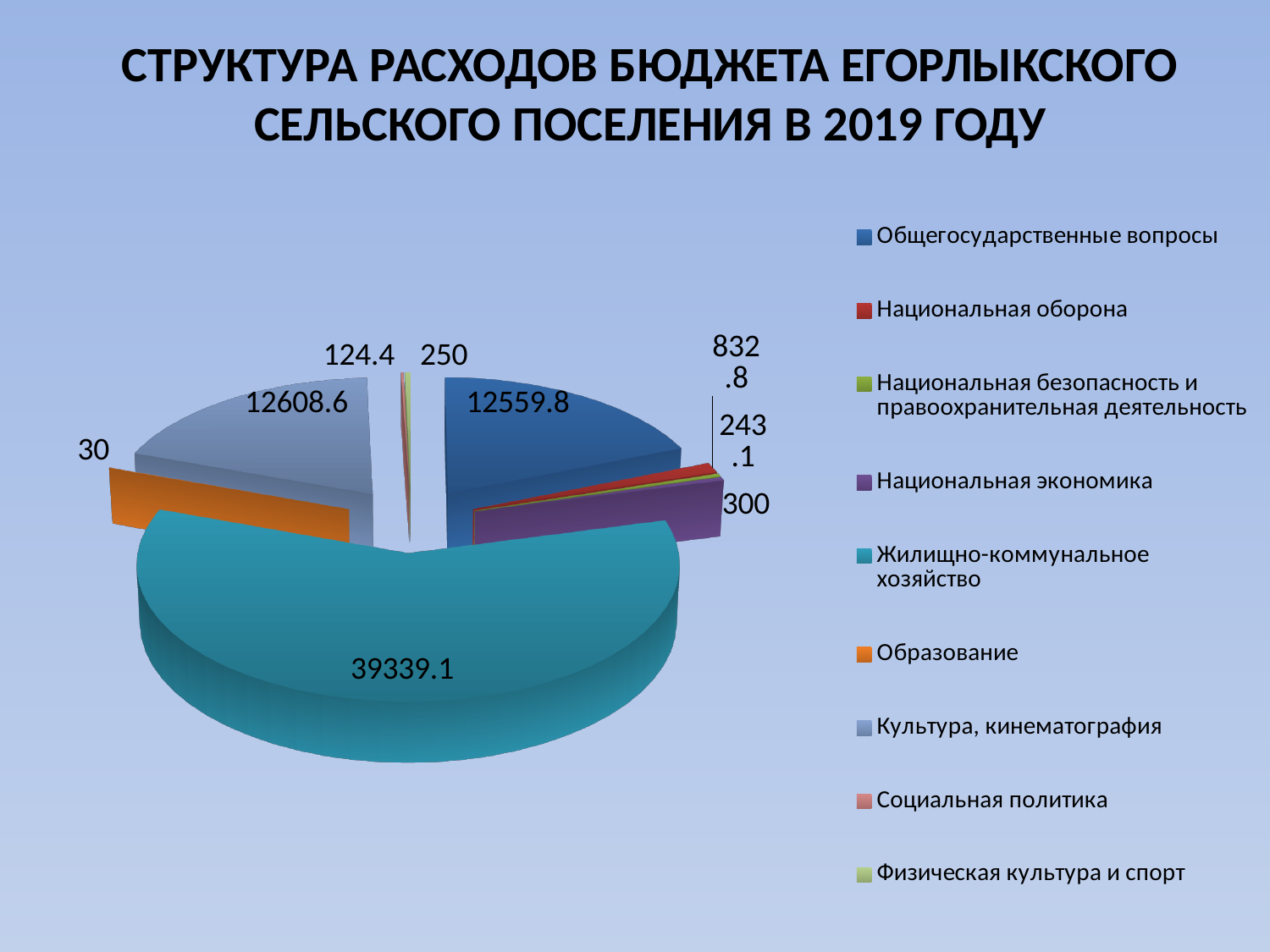
Which category has the largest slice of the pie? Жилищно-коммунальное хозяйство What is the value for Культура, кинематография? 12608.6 What is the value for Общегосударственные вопросы? 12559.8 What type of chart is shown on the slide? Pie chart Which is larger: the value for Национальная экономика or the value for Физическая культура и спорт? Национальная экономика What is the title of the chart? СТРУКТУРА РАСХОДОВ БЮДЖЕТА ЕГОРЛЫКСКОГО СЕЛЬСКОГО ПОСЕЛЕНИЯ В 2019 ГОДУ What is the difference between the values for Культура, кинематография and Общегосударственные вопросы? 48.8 How many categories does the legend list? 9 What is the value for Жилищно-коммунальное хозяйство? 39339.1 What is the value for Образование? 30 Which category has the smallest value? Образование What is the value for Национальная оборона? 832.8